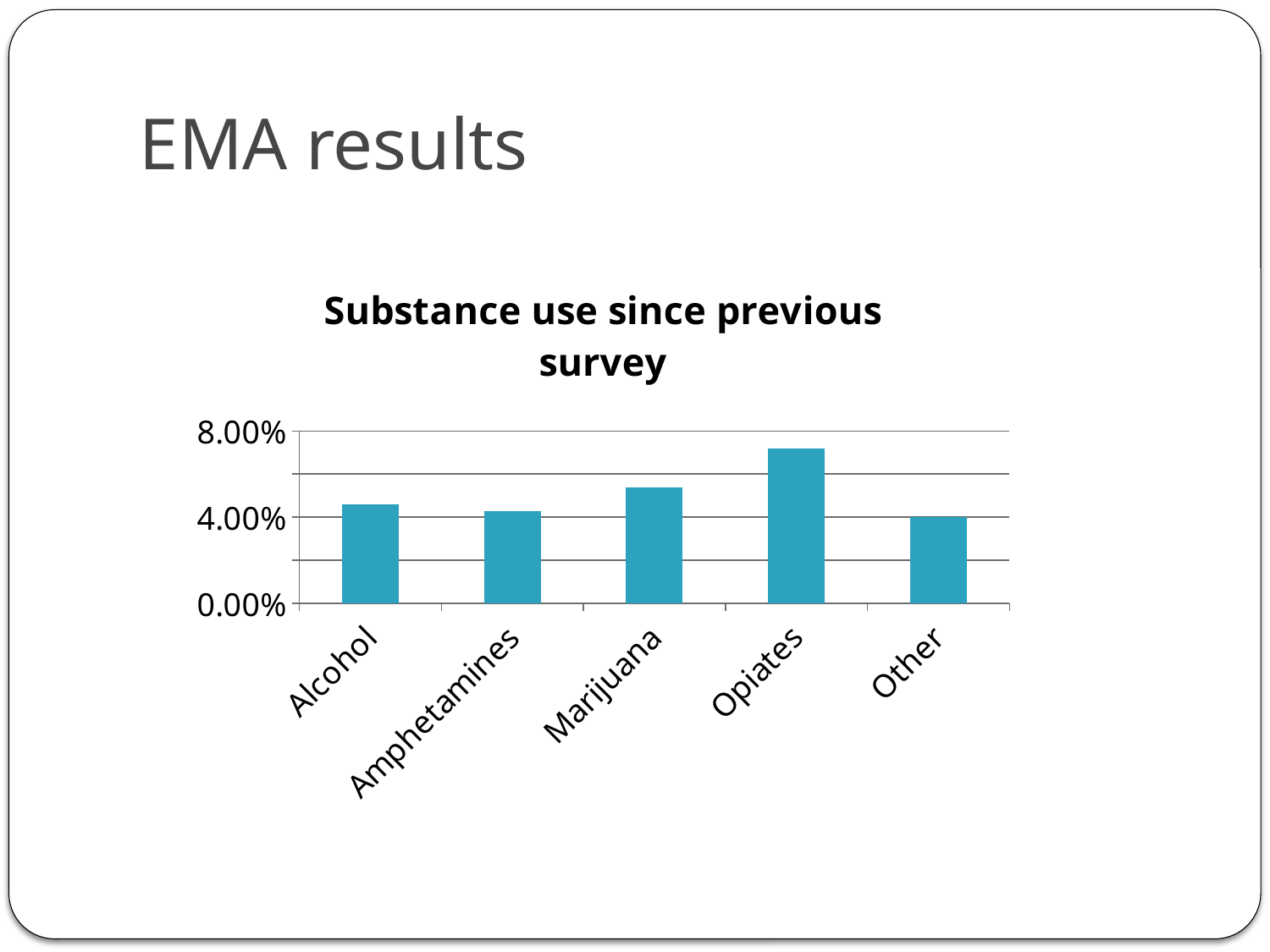
How many substance categories are shown on the x axis? 5 What is the highest value labelled on the vertical axis? 8.00% Is the value for Alcohol greater or less than 8.00%? less What is the title of the chart? Substance use since previous survey Which substance has the highest value? Opiates Is the value for Marijuana greater or less than 4.00%? greater What kind of chart is shown on the slide? bar chart Which is larger, the value for Marijuana or the value for Amphetamines? Marijuana Which is larger, the value for Opiates or the value for Alcohol? Opiates Which is larger, the value for Opiates or the value for Other? Opiates Is the value for Opiates greater or less than 8.00%? less